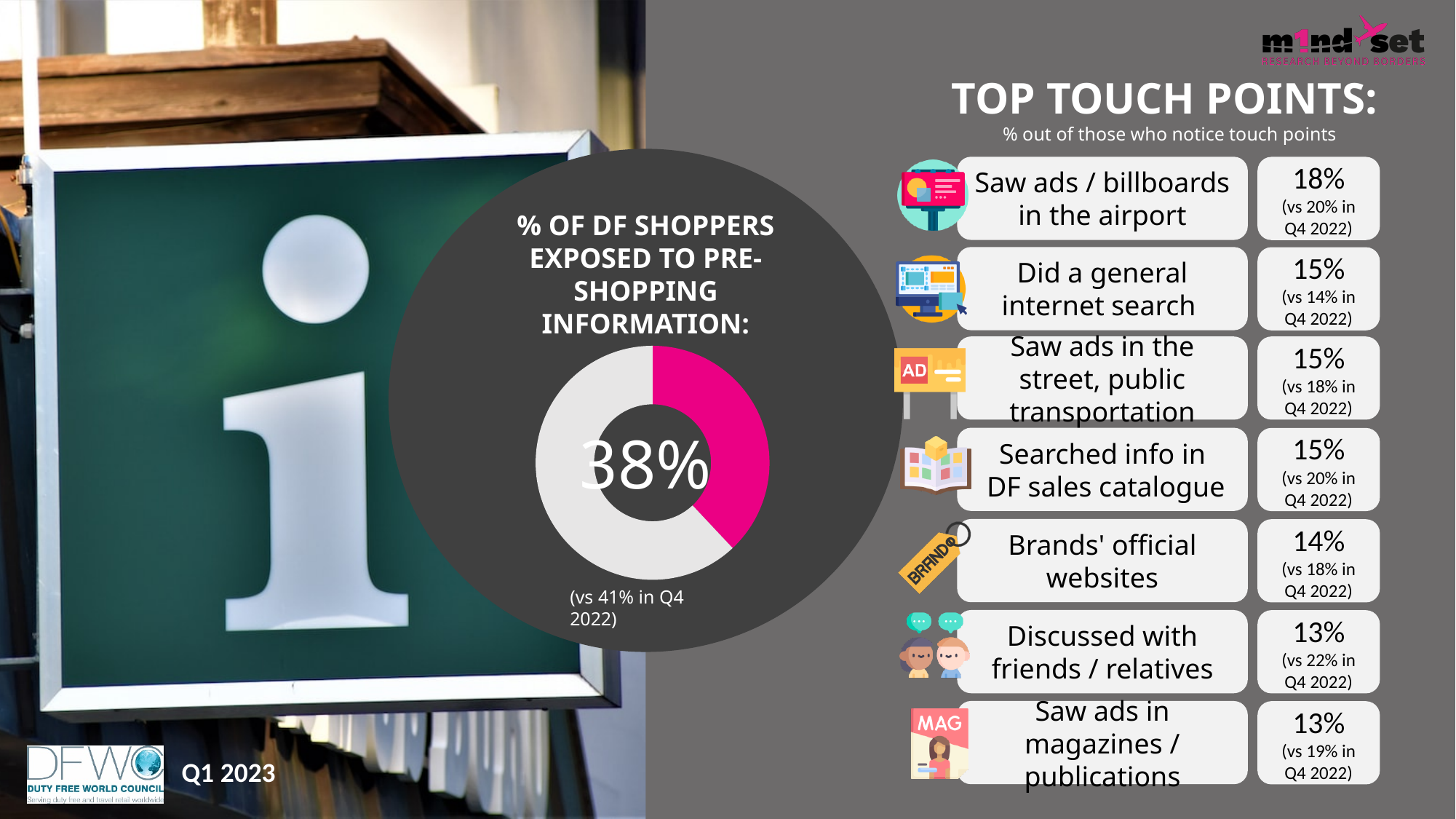
Which period had the higher share of DF shoppers exposed to pre-shopping information: Q1 2023 or Q4 2022? Q4 2022 What kind of chart is used to show the % of DF shoppers exposed to pre-shopping information? donut chart In the Top Touch Points list, which touch point has the highest percentage? Saw ads / billboards in the airport Is the value shown in the donut chart greater or less than 50%? less According to the donut chart, what was the percentage of DF shoppers exposed to pre-shopping information in Q4 2022? 41% In the Top Touch Points list, by how many percentage points did 'Discussed with friends / relatives' fall from Q4 2022 (22%) to the current 13%? 9 percentage points By how many percentage points did the share of DF shoppers exposed to pre-shopping information change from Q4 2022 (41%) to the current 38%? 3 percentage points How many touch points are listed in the Top Touch Points section? 7 In the Top Touch Points list, what percentage is shown for 'Discussed with friends / relatives'? 13% What is the title of the donut chart? % OF DF SHOPPERS EXPOSED TO PRE-SHOPPING INFORMATION What percentage of DF shoppers were exposed to pre-shopping information according to the donut chart? 38% What colour is the highlighted segment of the donut chart representing 38%? pink